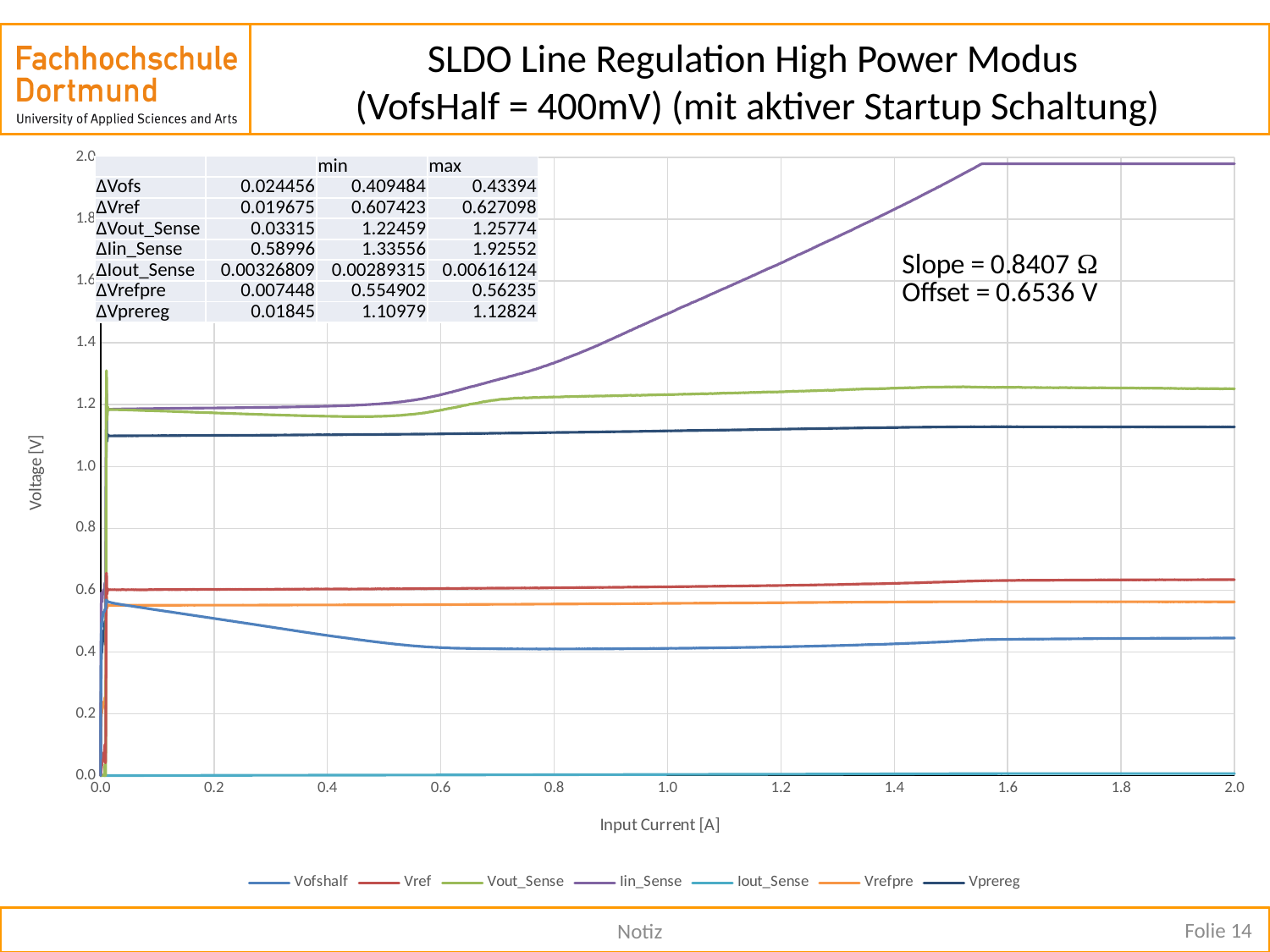
Is the value of Iin_Sense at an input current of 2.0 A greater or less than 1.8? greater Which series has the highest value at an input current of 2.0 A? Iin_Sense How many series does the chart legend list? 7 Is the value of Vprereg at an input current of 1.0 A greater or less than 1.0? greater Is the value of Vofshalf at an input current of 1.0 A greater or less than 0.6? less What kind of chart is shown on the slide? line chart Does the Iin_Sense series rise or fall between input currents of 0.6 A and 1.4 A? rise At an input current of 2.0 A, which is larger, Vref or Vrefpre? Vref What slope value is annotated on the chart? 0.8407 Ω According to the table on the chart, what is the max value of ΔIin_Sense? 1.92552 Which series has the lowest value across the whole input current range? Iout_Sense At an input current of 1.0 A, which is larger, Vout_Sense or Vprereg? Vout_Sense